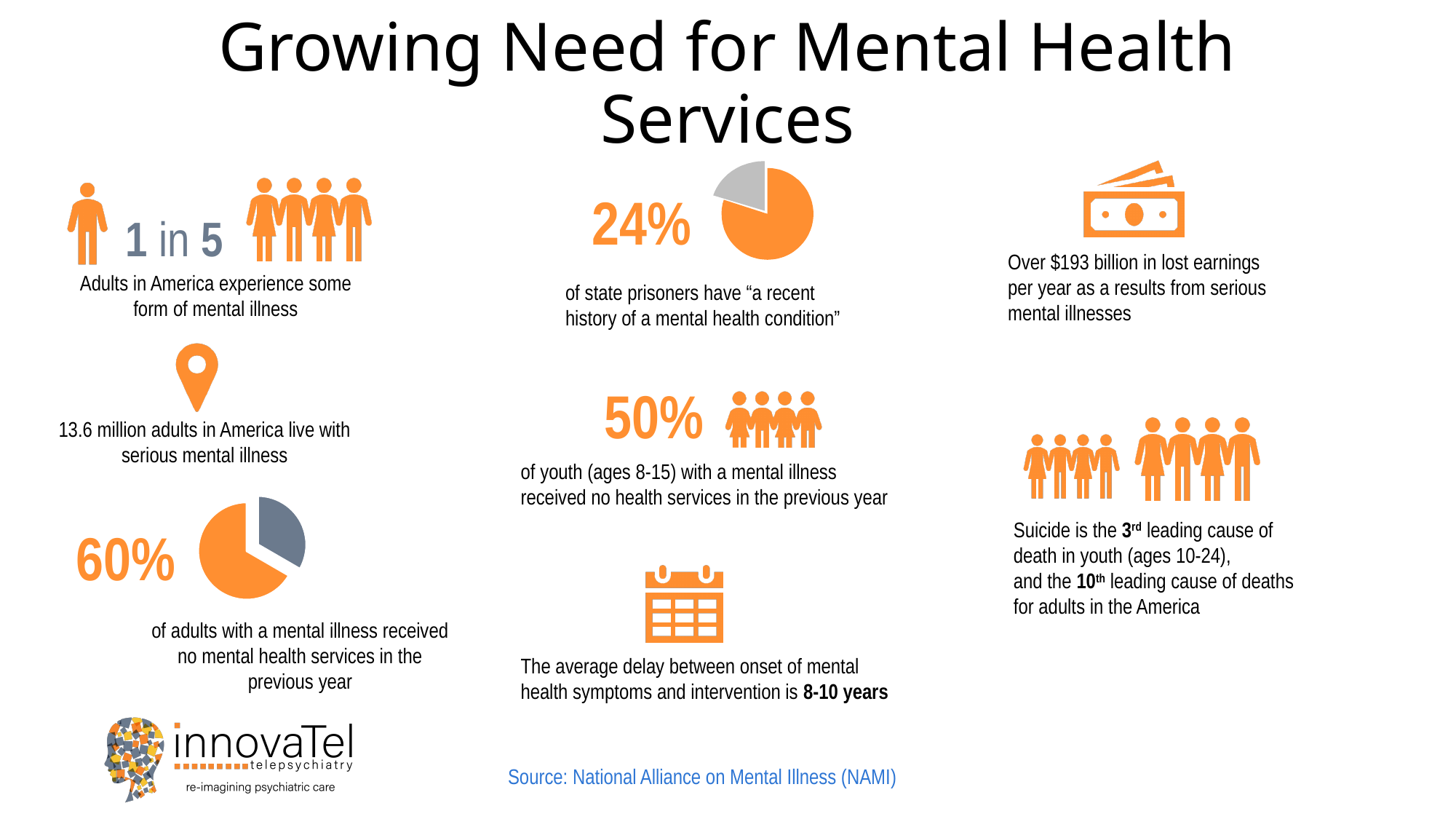
What is the title of the slide containing the pie charts? Growing Need for Mental Health Services How many slices does the pie chart next to the 60% figure have? 2 Is the share shown for the pie chart about state prisoners greater or less than 50%? less In the pie chart next to the 60% figure, which slice is larger, the orange one or the grey one? orange In the pie chart next to the 24% figure, which slice is larger, the orange one or the grey one? orange What kind of chart is shown next to the 60% figure on the left of the slide? pie chart How many slices does the pie chart next to the 24% figure have? 2 Is the share shown for the pie chart about adults receiving no mental health services greater or less than 50%? greater What source is cited for the data on the slide? National Alliance on Mental Illness (NAMI) What kind of chart is shown next to the 24% figure in the middle of the slide? pie chart What percentage is printed beside the pie chart about adults with a mental illness who received no mental health services? 60% What percentage is printed beside the pie chart about state prisoners? 24%